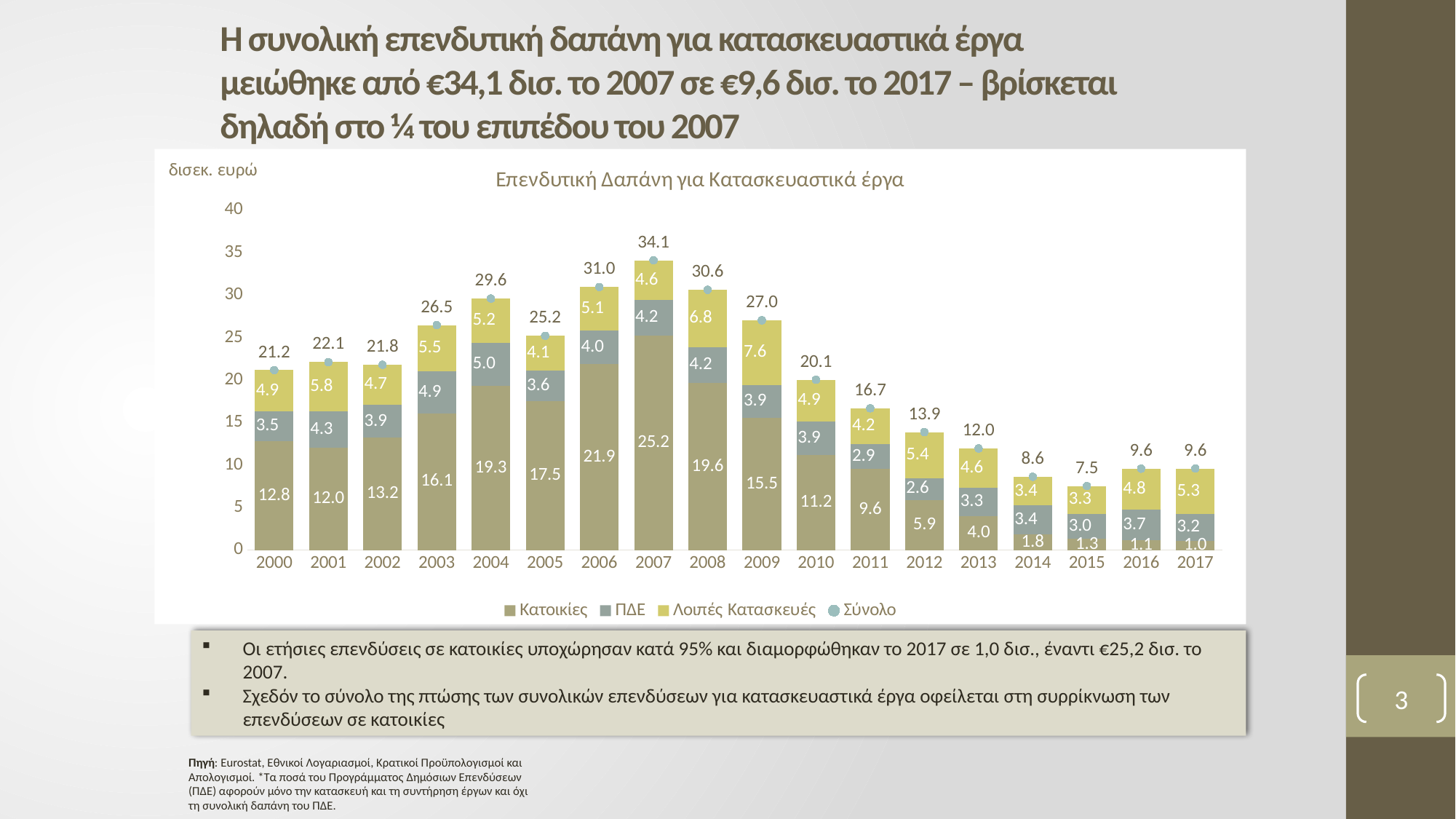
Which year has the lowest Σύνολο value? 2015 Which year has the highest Σύνολο value? 2007 What is the Σύνολο value for 2017? 9.6 Do the Σύνολο values rise or fall from 2007 to 2015? Fall Which is larger, the Κατοικίες value for 2004 or for 2008? 2008 What kind of chart is this? Stacked bar chart How many years are shown on the x axis? 18 What is the ΠΔΕ value for 2000? 3.5 What is the value of Κατοικίες for 2007? 25.2 What is the value of Λοιπές Κατασκευές for 2009? 7.6 How many entries does the legend list? 4 What is the difference between the Σύνολο values for 2007 and 2017? 24.5